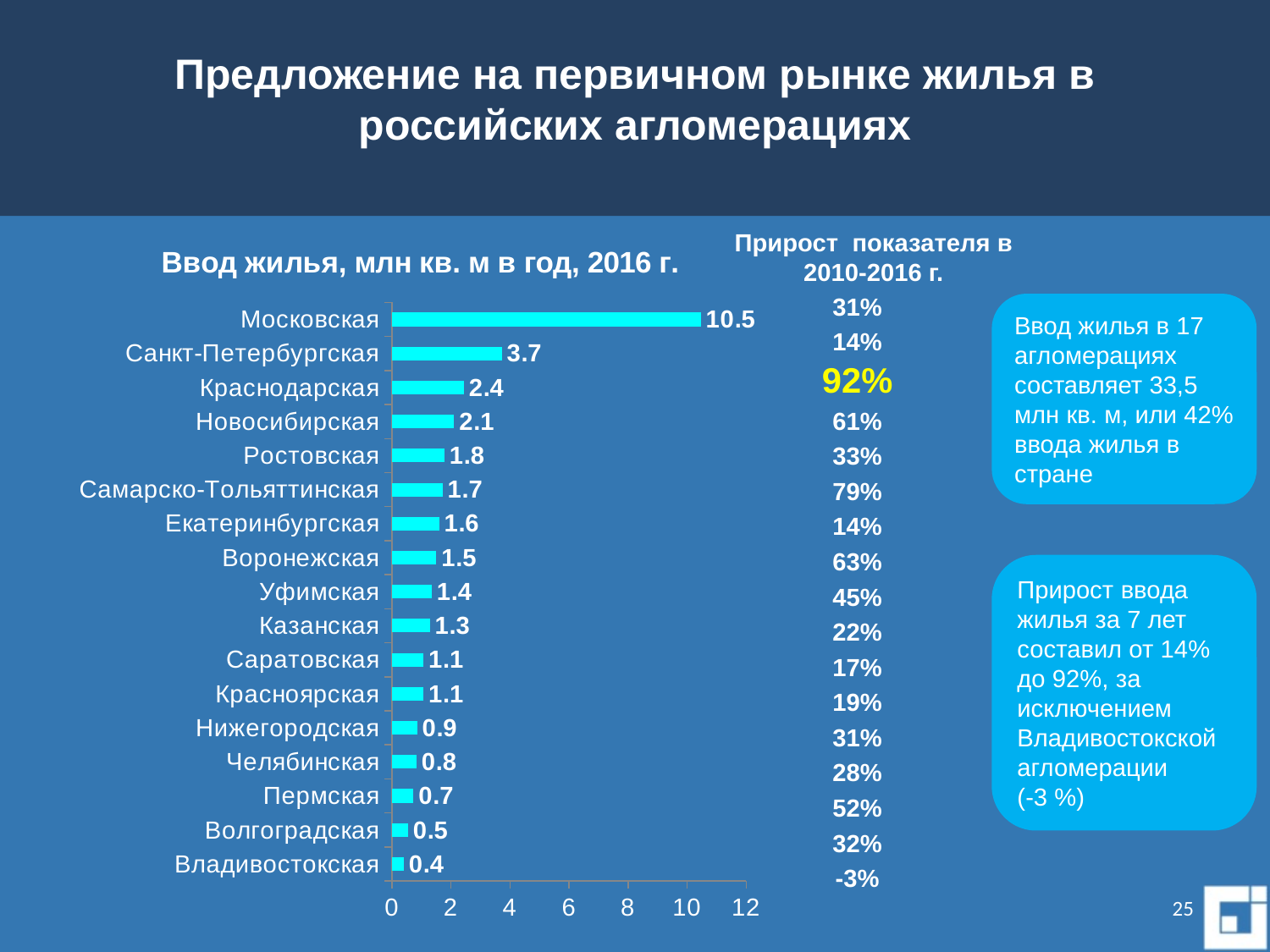
Which has the larger value, Краснодарская or Новосибирская? Краснодарская What is the value for Московская in the chart? 10.5 What is the title of the chart on the slide? Ввод жилья, млн кв. м в год, 2016 г. What is the difference between the values for Московская and Санкт-Петербургская? 6.8 What is the value for Воронежская in the chart? 1.5 Is the value for Московская greater or less than 10? greater What is the value for Владивостокская in the chart? 0.4 What is the value for Санкт-Петербургская in the chart? 3.7 Which agglomeration has the highest value in the chart? Московская What kind of chart is shown on the slide? bar chart Which agglomeration has the lowest value in the chart? Владивостокская How many agglomerations (categories) are plotted in the chart? 17